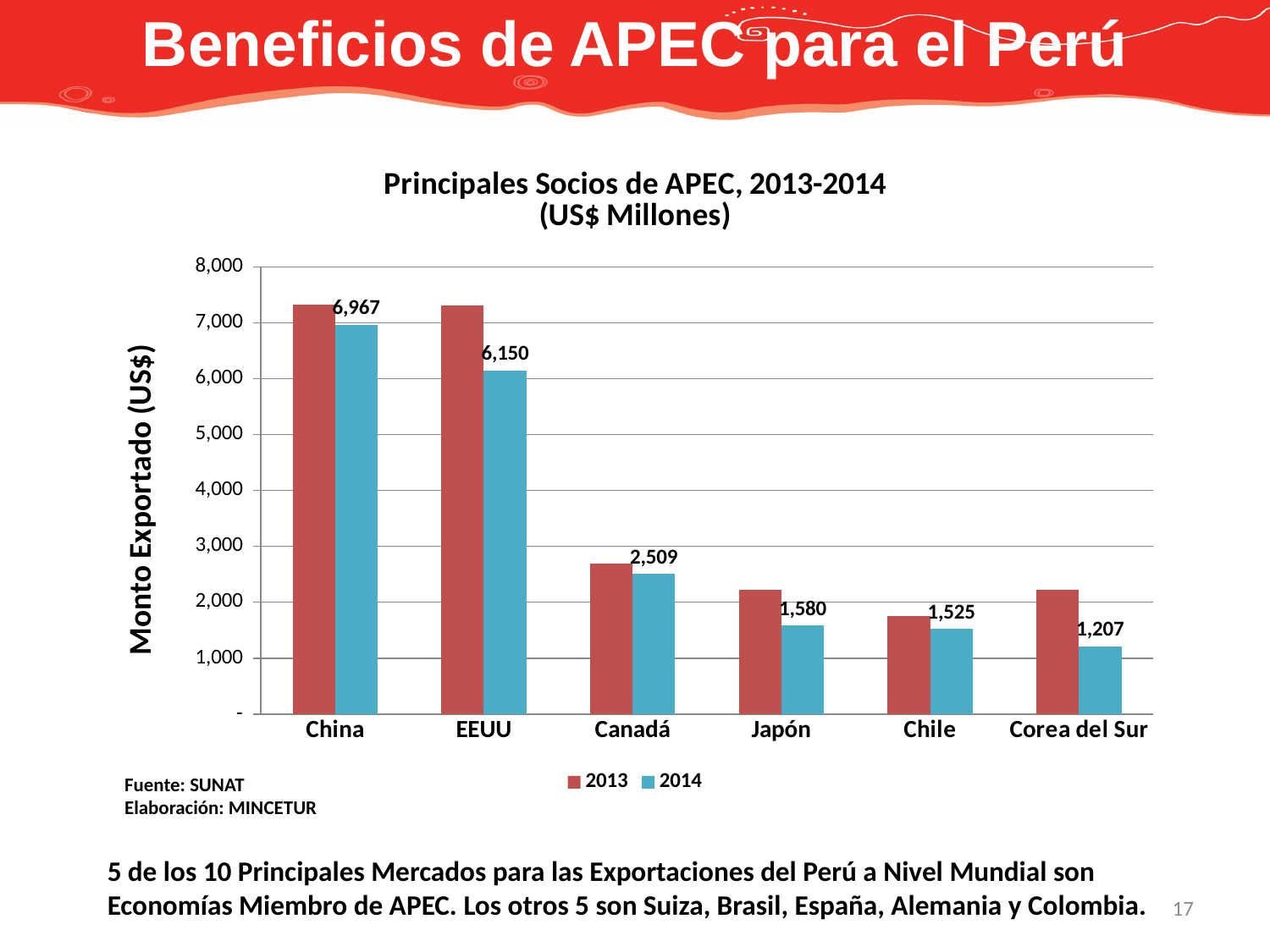
What was the export amount to Corea del Sur in 2014? 1,207 What was the export amount to China in 2014? 6,967 Which market had the highest export amount in 2014? China How many markets are shown on the x axis? 6 Is the 2013 export amount to China greater or less than 7,000? greater Which market had the lowest export amount in 2014? Corea del Sur Which had a larger 2014 export amount, Japón or Chile? Japón What is the difference between the 2014 export amounts to China and EEUU? 817 How many series does the legend list? 2 Is the 2013 export amount to Chile greater or less than 2,000? less What kind of chart is shown on the slide? Bar chart What was the export amount to EEUU in 2014? 6,150